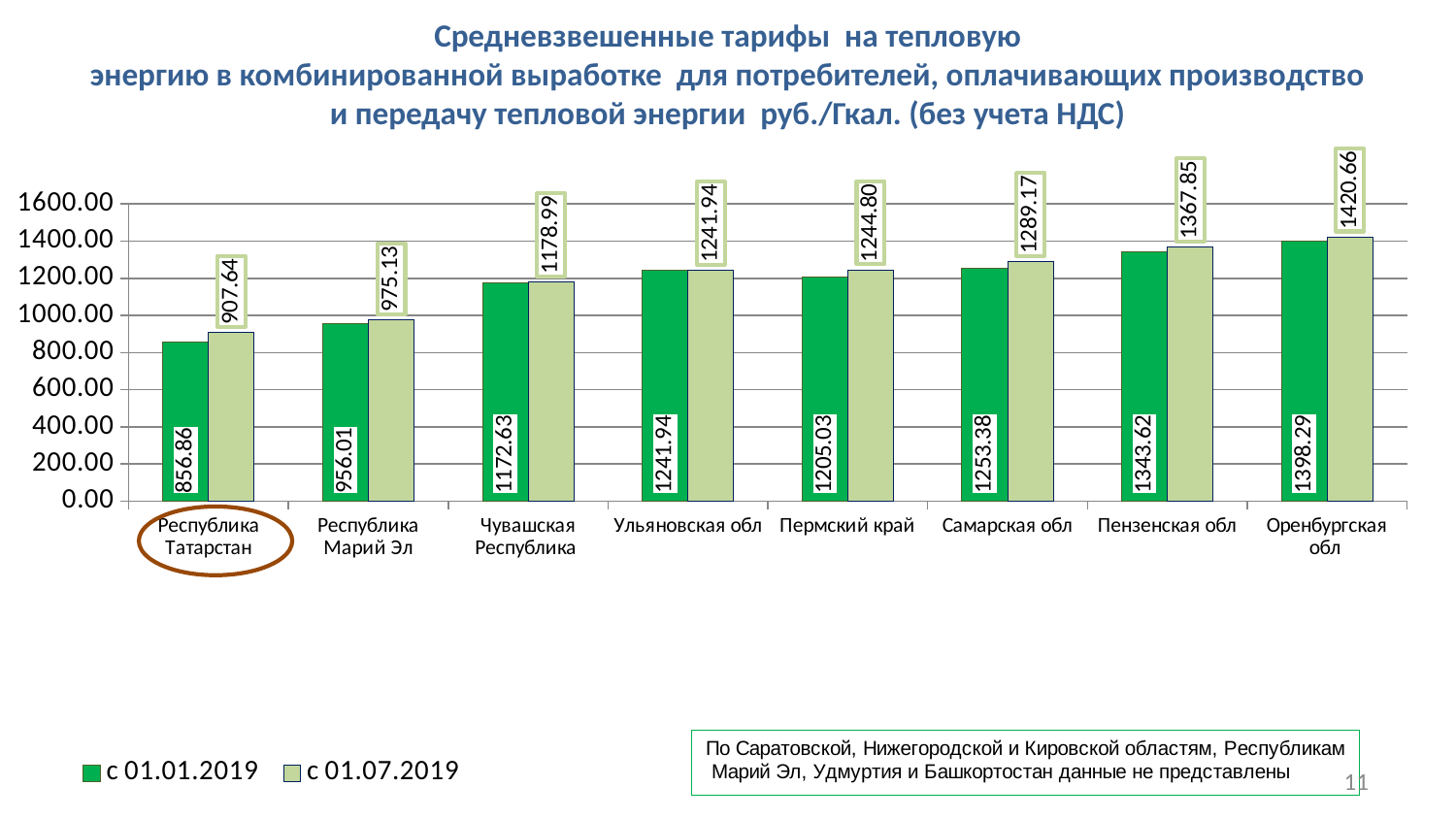
What is the value for Пермский край in the series с 01.07.2019? 1244.80 Which is larger: the с 01.01.2019 value for Самарская обл or the с 01.07.2019 value for Ульяновская обл? Самарская обл (с 01.01.2019) Which region has the lowest value in the series с 01.01.2019? Республика Татарстан Which region has the highest value in the series с 01.07.2019? Оренбургская обл How many regions are shown on the x axis? 8 Do the с 01.07.2019 values rise or fall from left to right along the x axis? Rise What is the value for Республика Татарстан in the series с 01.01.2019? 856.86 What is the difference between the с 01.07.2019 and с 01.01.2019 values for Оренбургская обл? 22.37 What kind of chart is shown on the slide? Bar chart What is the value for Оренбургская обл in the series с 01.07.2019? 1420.66 What is the difference between the с 01.07.2019 and с 01.01.2019 values for Республика Татарстан? 50.78 How many series does the legend list? 2